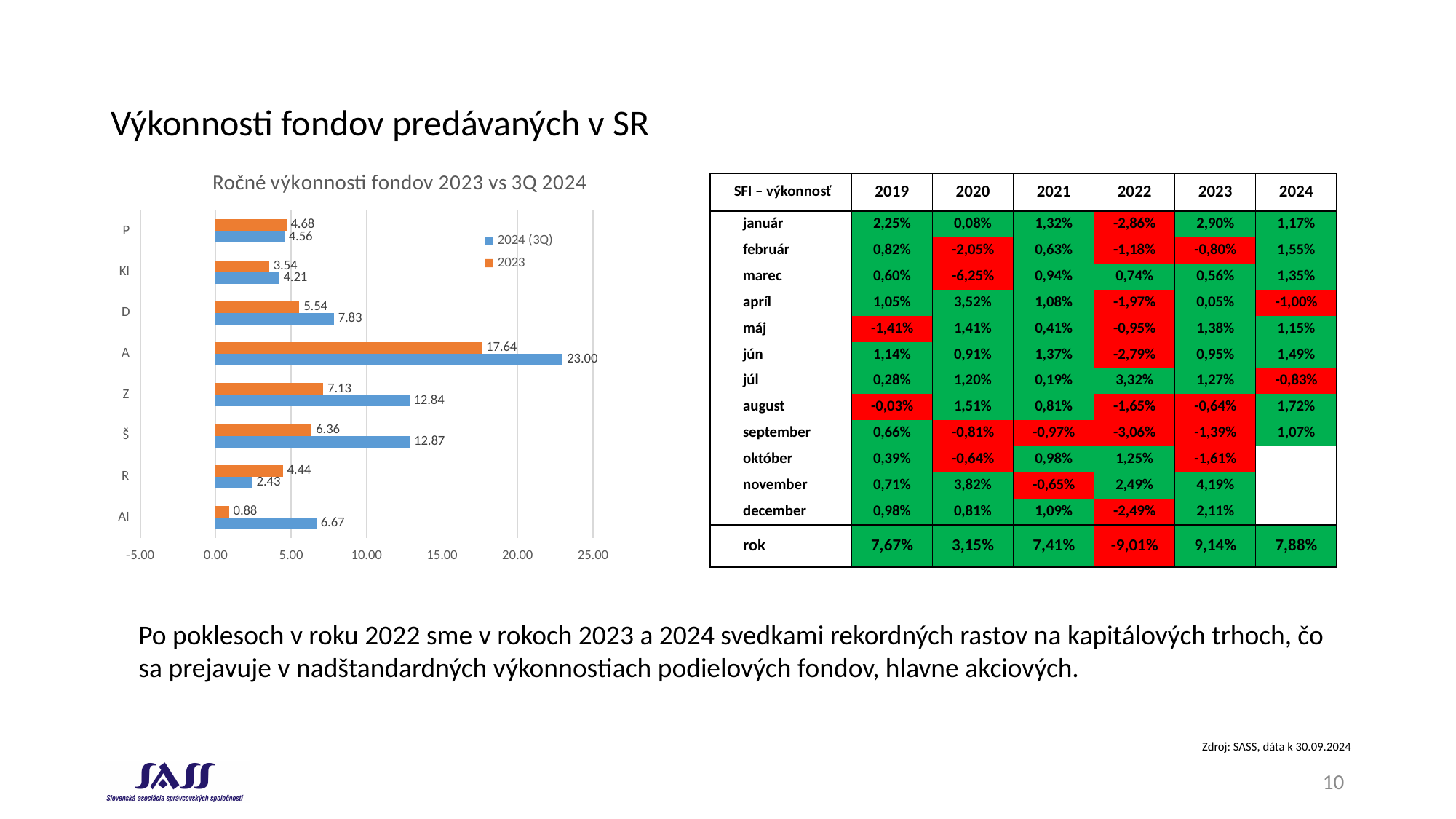
Which category has the lowest 2023 value? AI What is the difference between the 2024 (3Q) and 2023 values for category A? 5.36 What is the 2024 (3Q) value for category A? 23.00 What is the 2023 value for category AI? 0.88 For category R, which is larger: the 2023 value or the 2024 (3Q) value? 2023 Which category has the lowest 2024 (3Q) value? R What is the title of the chart on the slide? Ročné výkonnosti fondov 2023 vs 3Q 2024 How many series does the chart legend list? 2 Which category has the highest 2024 (3Q) value? A What type of chart is shown on the slide? bar chart What is the 2023 value for category Z? 7.13 How many categories are shown on the chart's vertical axis? 8